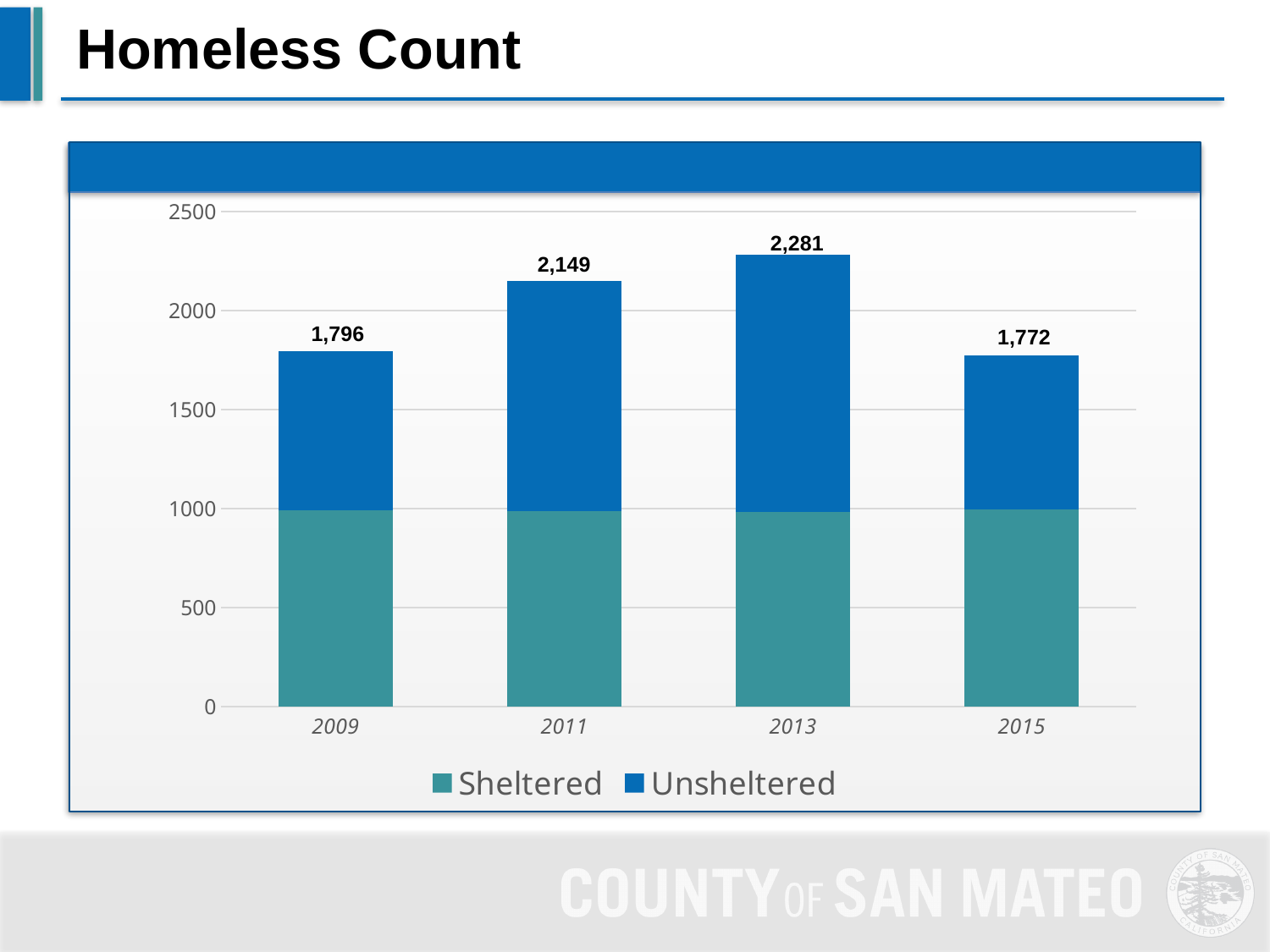
What is the total homeless count shown for 2009? 1,796 How many years are shown on the x axis? 4 What is the difference between the total homeless count in 2013 and in 2009? 485 How many series does the legend list? 2 What is the total homeless count shown for 2013? 2,281 Is the Sheltered value for 2015 greater or less than 1500? less Which year has a larger total homeless count, 2011 or 2015? 2011 Which year has the highest total homeless count? 2013 What kind of chart is shown on the slide? Stacked bar chart What is the difference between the total homeless count in 2011 and in 2015? 377 Which year has the lowest total homeless count? 2015 What is the total homeless count shown for 2015? 1,772